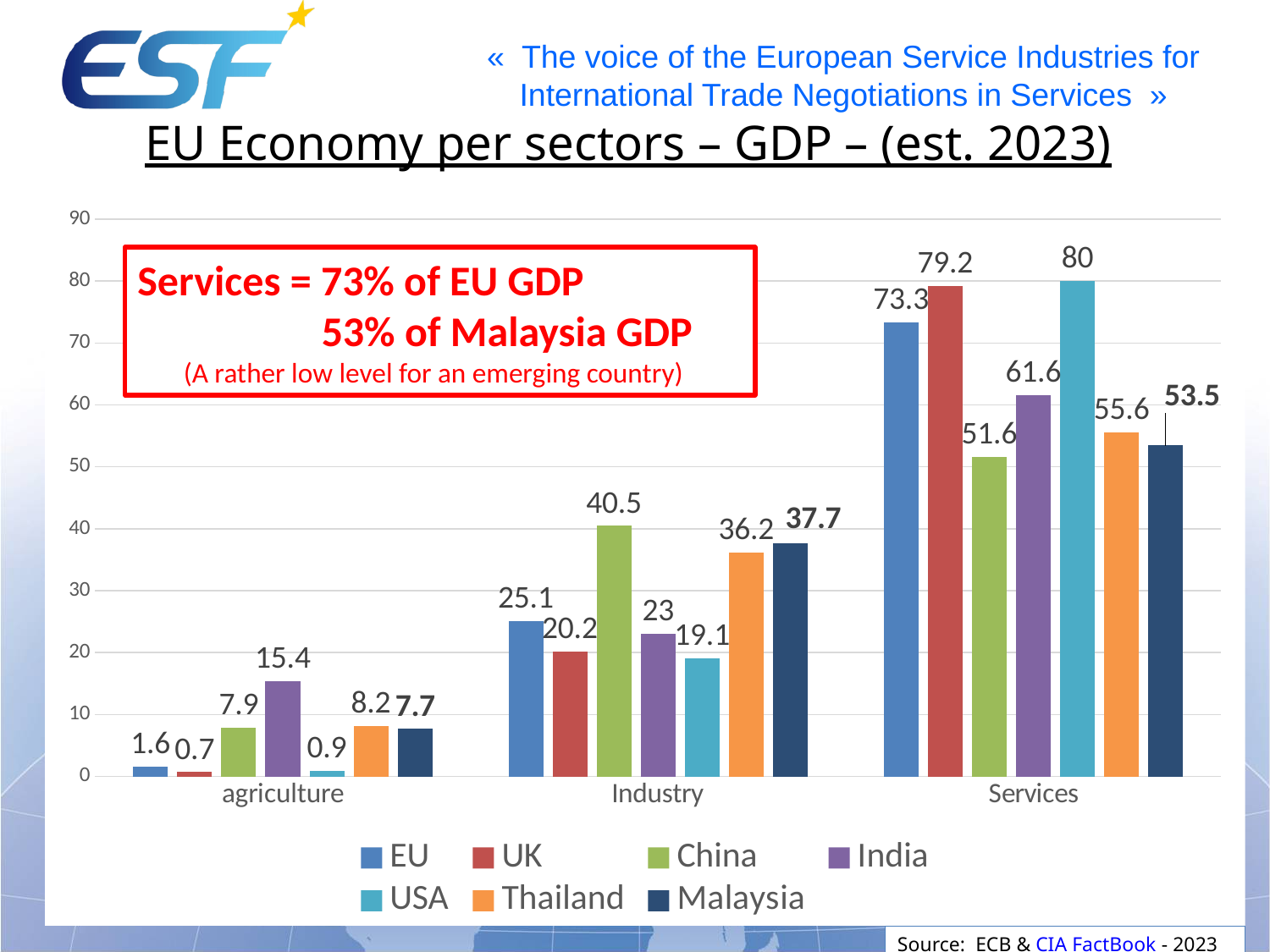
How many series does the legend list? 7 What is the value for Malaysia in the Services category? 53.5 Which series has the lowest value in the agriculture category? UK In the Industry category, which is larger: Thailand or Malaysia? Malaysia What is the title of the chart? EU Economy per sectors – GDP – (est. 2023) What is the value for India in the agriculture category? 15.4 Which series has the highest value in the Industry category? China How many categories are shown on the x axis? 3 Which series has the highest value in the Services category? USA What kind of chart is shown on the slide? Bar chart What is the value for USA in the Services category? 80 What is the difference between the UK and EU values in the Services category? 5.9